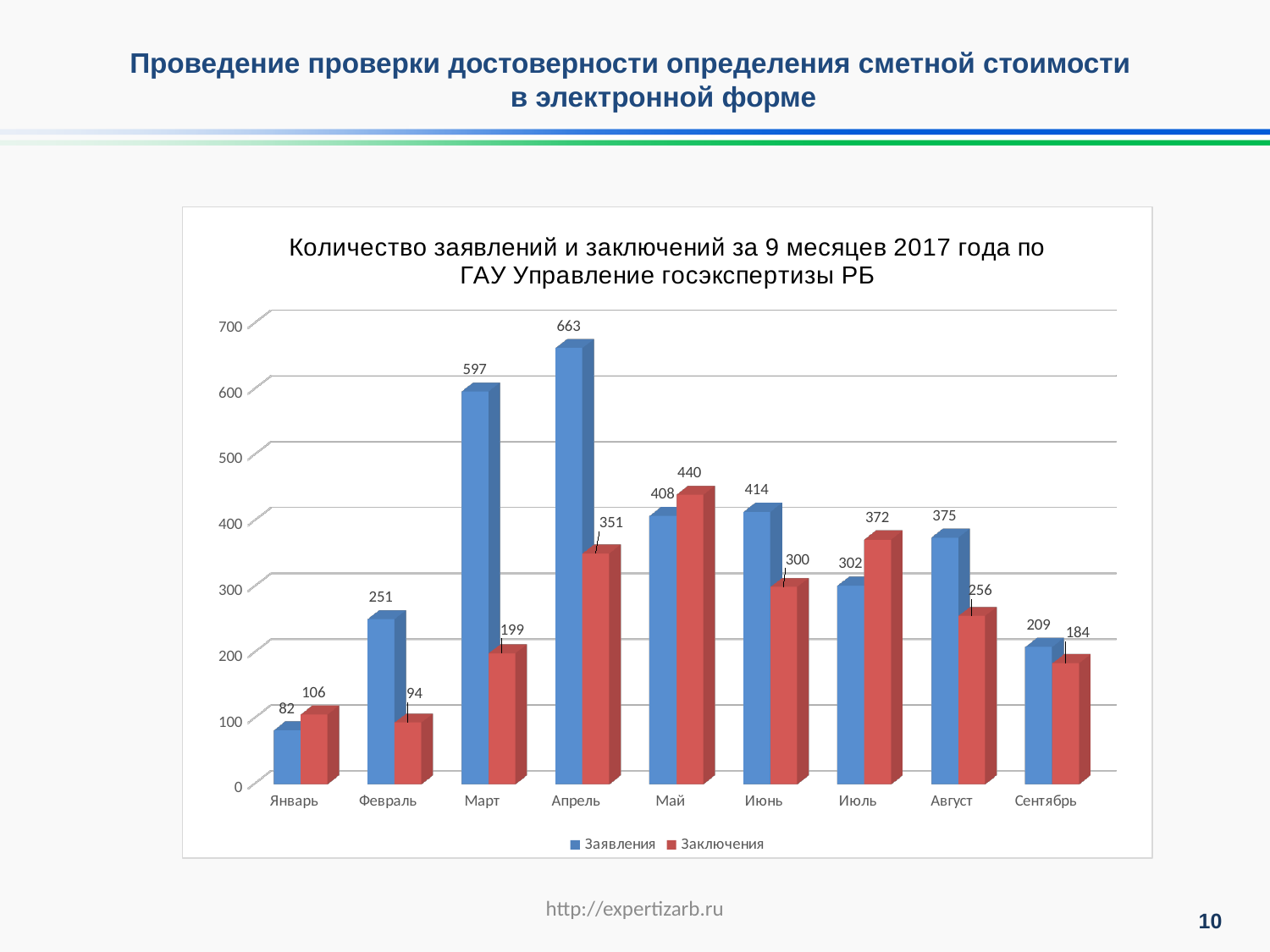
How many months are shown on the x axis? 9 How many series does the legend list? 2 What kind of chart is shown on the slide? Bar chart What is the difference between Заявления and Заключения in Март? 398 What is the value of Заключения for Май? 440 Which month has the lowest value for Заключения? Февраль What is the value of Заключения for Март? 199 Do the Заявления values rise or fall from Апрель to Сентябрь? Fall What is the value of Заявления for Апрель? 663 Which month has the highest value for Заявления? Апрель Which is larger in Июль: Заявления or Заключения? Заключения What colour are the Заключения bars? Red